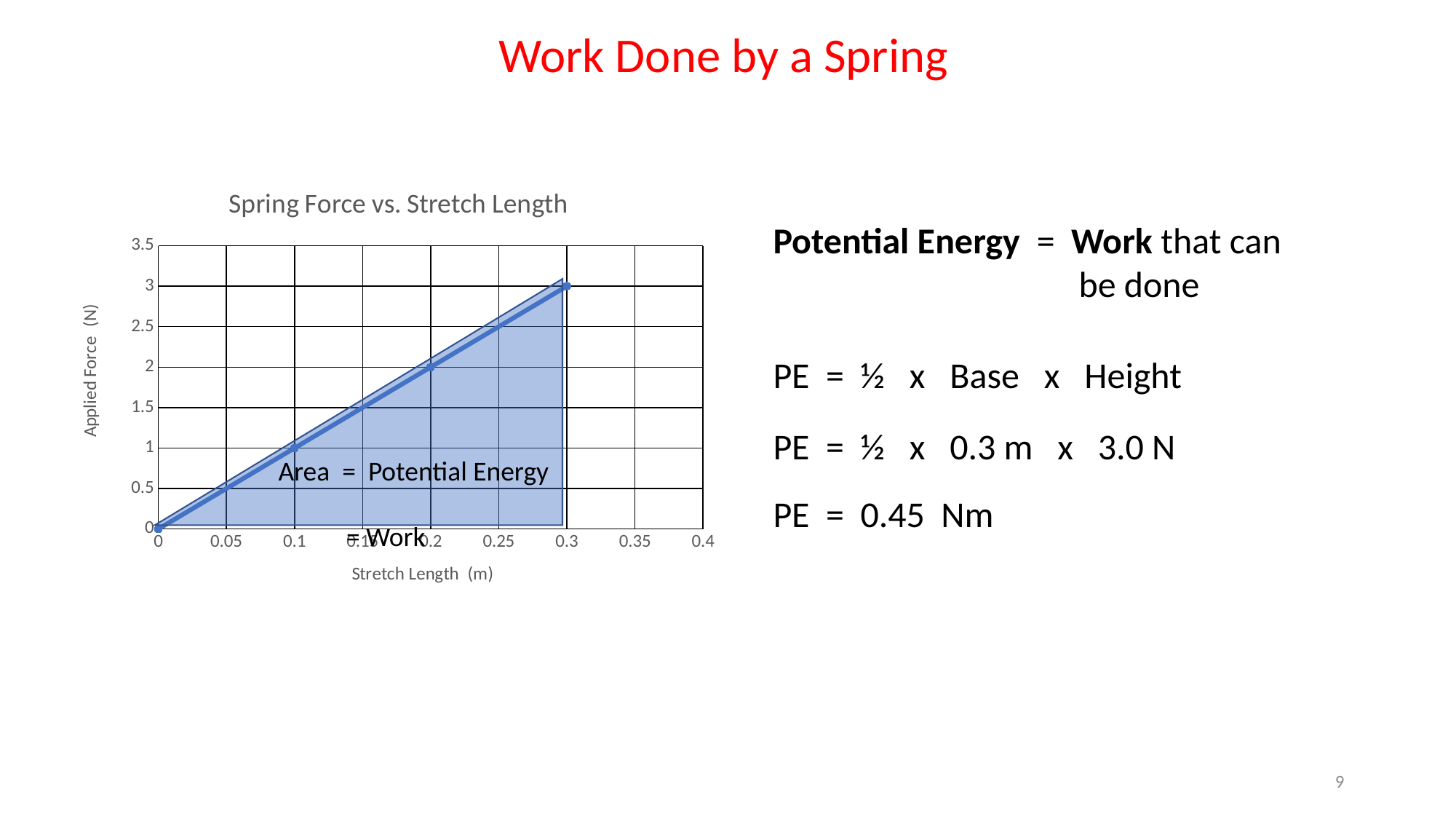
Do the plotted values rise or fall as stretch length increases? rise What is the title of the chart? Spring Force vs. Stretch Length What kind of chart is shown on the slide? line chart How many data points are plotted on the chart? 7 What is the label of the x axis? Stretch Length (m) What is the applied force at a stretch length of 0.2 m? 2 What is the applied force at a stretch length of 0.3 m? 3 Which has the larger applied force: a stretch length of 0.05 m or 0.15 m? 0.15 m At which stretch length is the applied force lowest? 0 Is the applied force at a stretch length of 0.25 m greater or less than 2? greater What is the applied force at a stretch length of 0.1 m? 1 At which stretch length is the applied force highest? 0.3